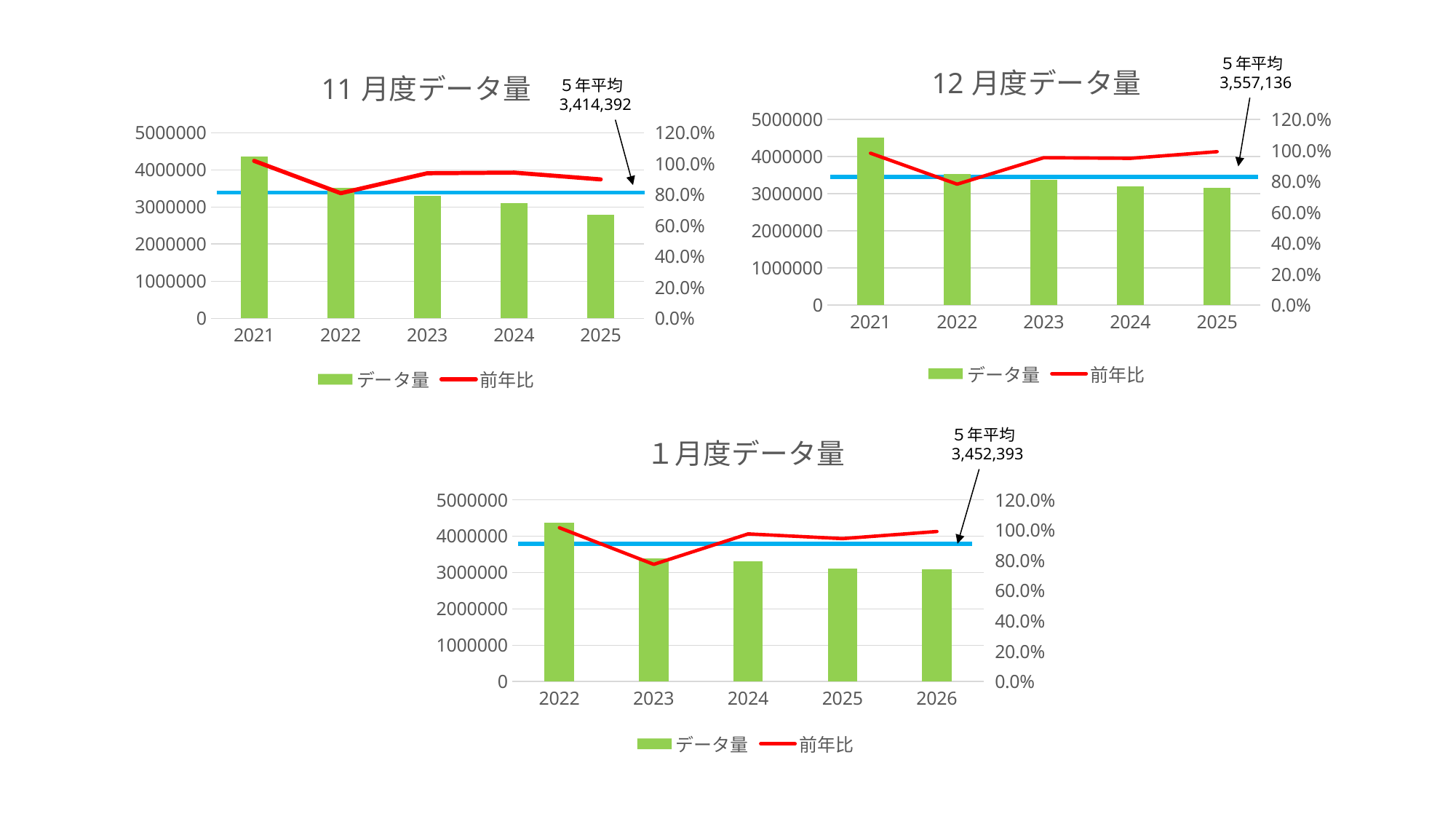
In the 1月度データ量 chart, which year has the highest データ量 bar? 2022 In the 11月度データ量 chart, which year has the highest データ量 bar? 2021 In the 11月度データ量 chart, do the データ量 bars generally rise or fall from 2021 to 2025? fall In the 12月度データ量 chart, which year has the highest データ量 bar? 2021 In the 11月度データ量 chart, what is the 5年平均 value shown in the annotation? 3,414,392 In the 11月度データ量 chart, is the データ量 value for 2025 greater or less than 3000000? less In the 12月度データ量 chart, what is the 5年平均 value shown in the annotation? 3,557,136 In the 12月度データ量 chart, is the データ量 value for 2021 greater or less than 4000000? greater How many years are shown on the x axis of the 1月度データ量 chart? 5 How many series does the legend of the 12月度データ量 chart list? 2 In the 11月度データ量 chart, which year has the lowest データ量 bar? 2025 In the 1月度データ量 chart, what is the 5年平均 value shown in the annotation? 3,452,393